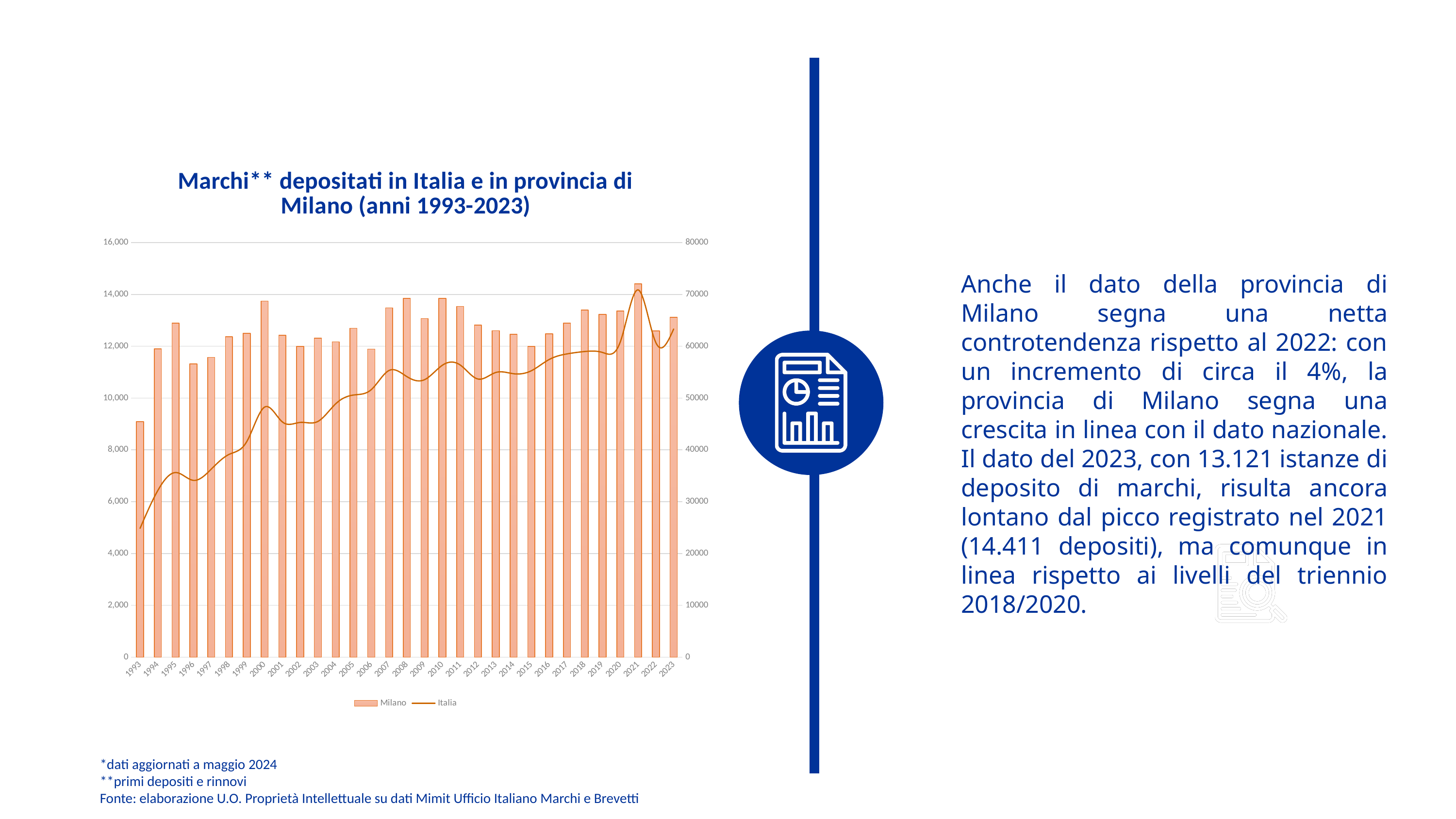
In which year is the Milano bar the lowest? 1993 In which year is the Milano bar the highest? 2021 Does the Italia line rise or fall between 1993 and 2000? Rises Is the Milano value for 2021 greater or less than 14,000? greater How many series does the legend list? 2 What is the title of the chart? Marchi** depositati in Italia e in provincia di Milano (anni 1993-2023) Is the Milano value for 1993 greater or less than 10,000? less What kind of chart is used to show the Milano series? Bar chart Which two series does the chart legend list? Milano and Italia Which year has the larger Milano bar, 2022 or 2023? 2023 How many years are shown on the x axis of the chart? 31 Is the Italia value for 1993 greater or less than 30000? less